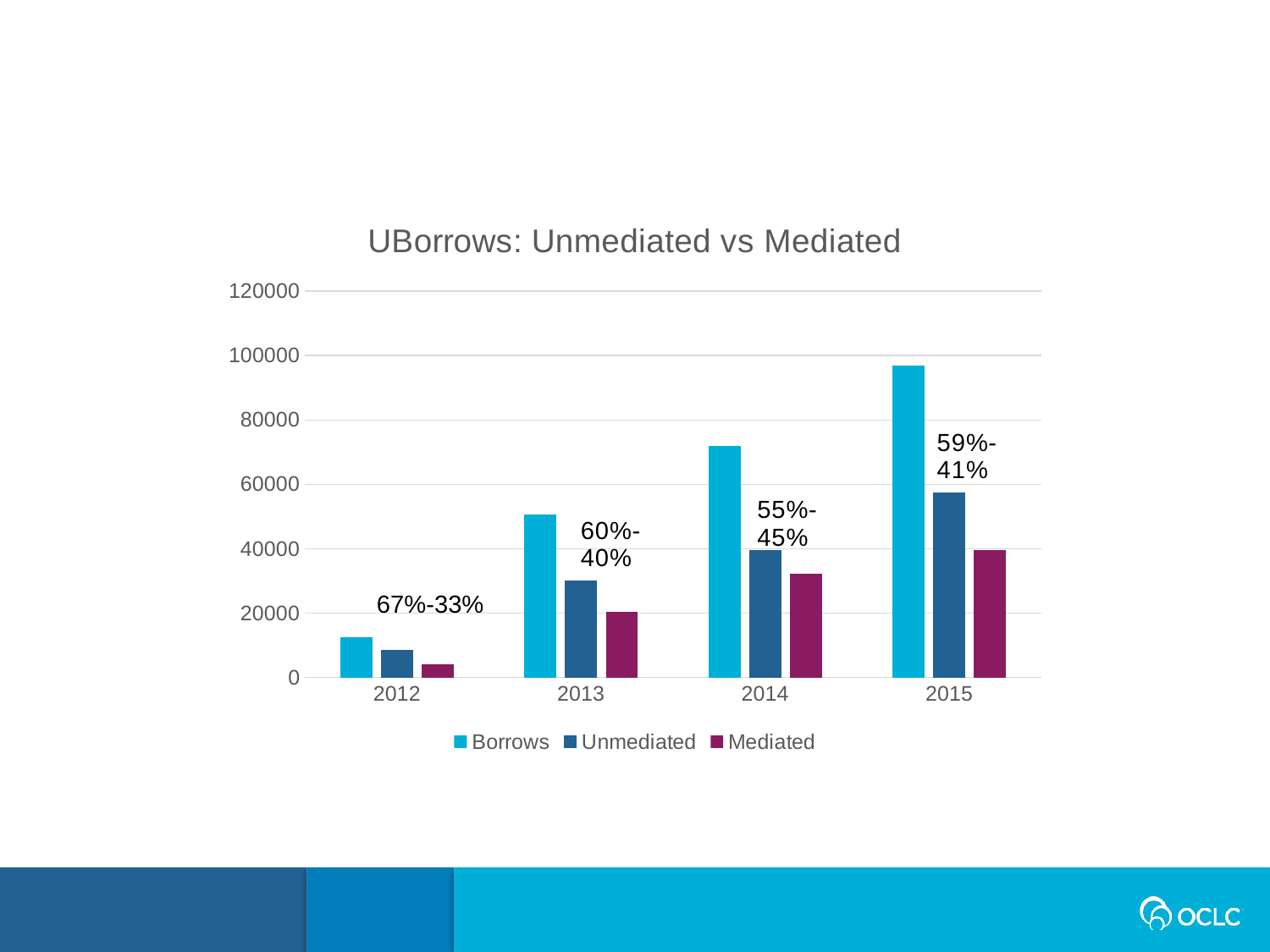
Is the Unmediated value for 2013 greater or less than 20000? greater Is the Borrows value for 2012 greater or less than 20000? less How many series does the legend list? 3 What type of chart is shown on the slide? bar chart Which year has the lowest Mediated value? 2012 Do the Borrows values rise or fall from 2012 to 2015? rise What percentage split label is printed above the 2012 bars? 67%-33% Is the Borrows value for 2015 greater or less than 80000? greater How many years are shown on the x axis? 4 What is the title of the chart? UBorrows: Unmediated vs Mediated Which year has the highest Borrows value? 2015 In 2015, which is larger, the Unmediated value or the Mediated value? Unmediated